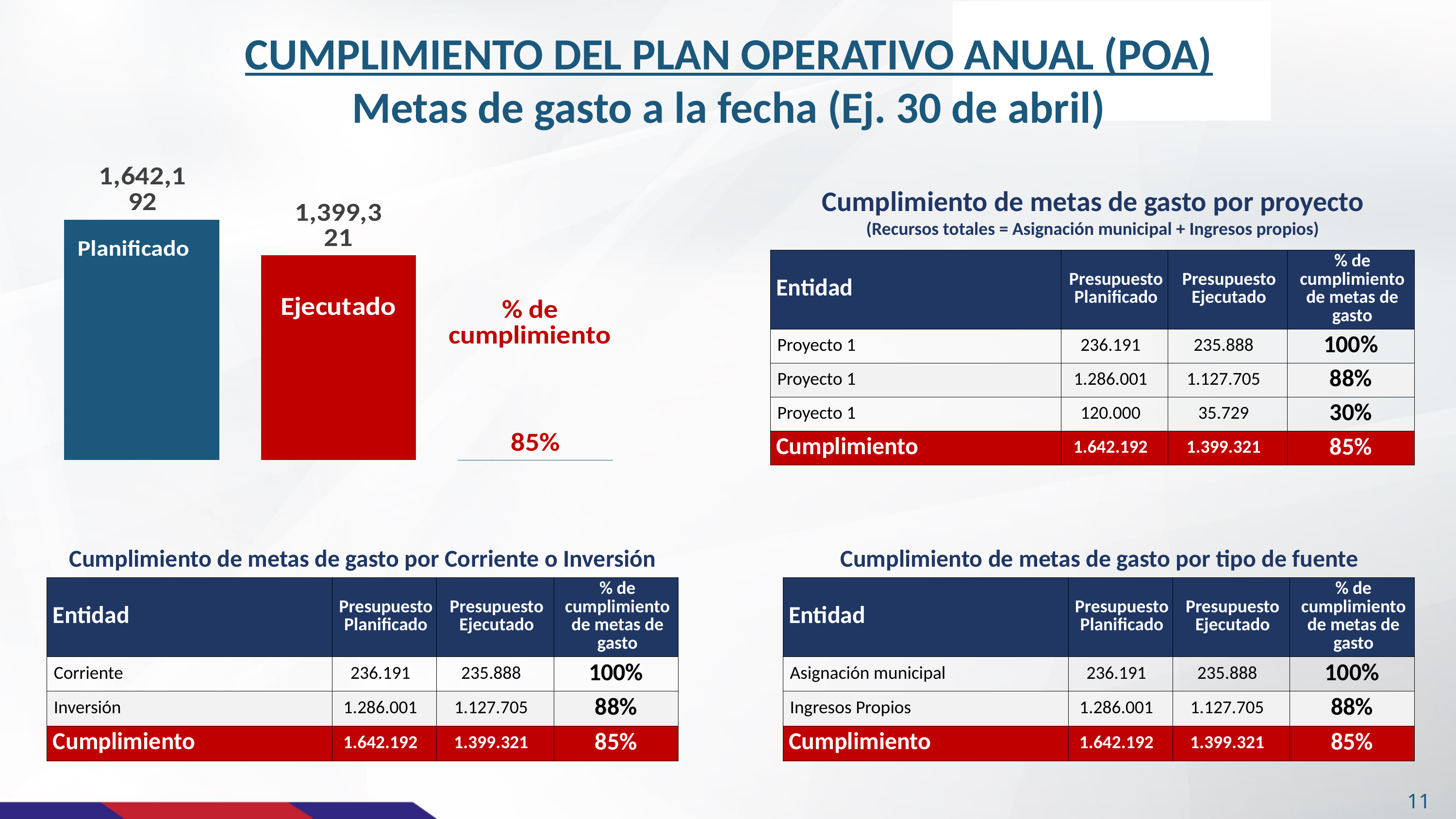
How many bars are shown in the chart? 2 What is the value of the Planificado bar in the bar chart? 1,642,192 What percentage of cumplimiento is shown next to the bar chart? 85% What type of chart is shown on the slide? Bar chart Which bar in the chart is the lowest? Ejecutado Which bar in the chart is the highest? Planificado What colour is the Ejecutado bar in the chart? Red What is the difference between the Planificado and Ejecutado values in the bar chart? 242,871 What is the value of the Ejecutado bar in the bar chart? 1,399,321 Which is larger in the bar chart, Planificado or Ejecutado? Planificado